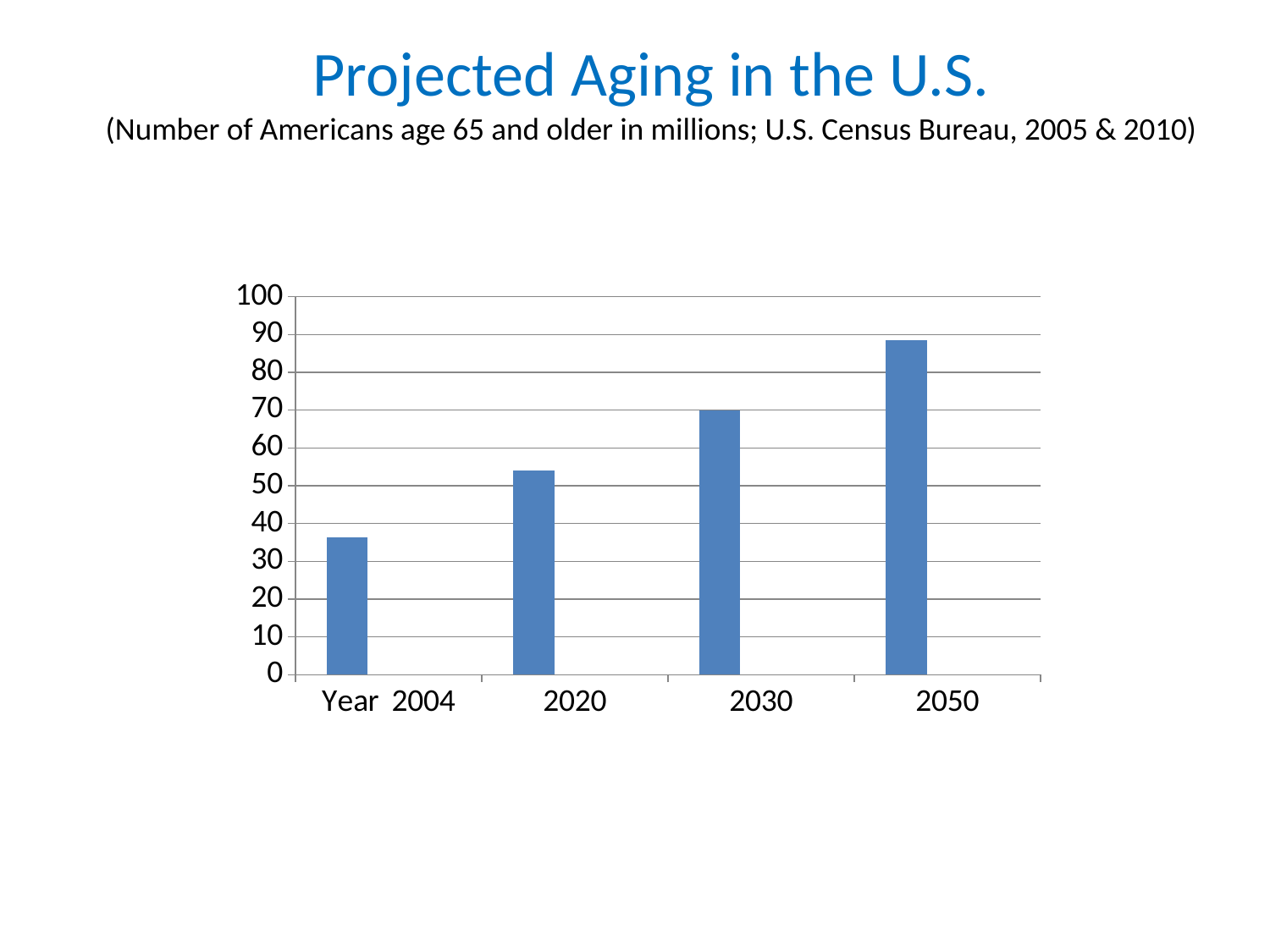
How many bars are plotted in the chart? 4 What is the title of the chart on the slide? Projected Aging in the U.S. Is the value for 2004 greater or less than 40? less Which year has the highest bar in the chart? 2050 Is the value for 2020 greater or less than 50? greater Which year has the lowest bar in the chart? 2004 What is the highest value shown on the vertical axis? 100 Is the value for 2050 greater or less than 80? greater What kind of chart is shown on the slide? bar chart Which is larger, the value for 2020 or the value for 2030? 2030 Do the values rise or fall from 2004 to 2050? rise